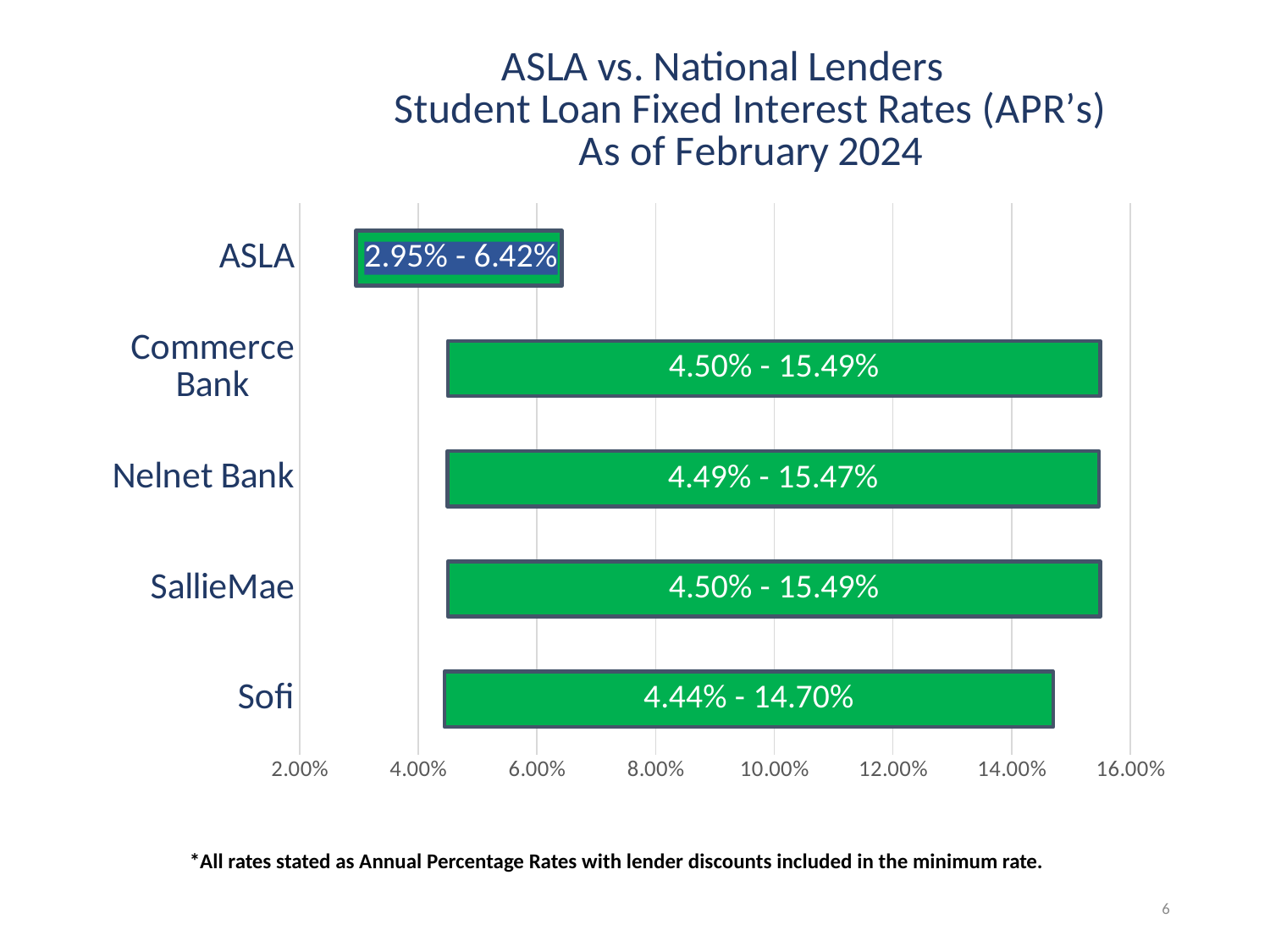
Is the upper end of the ASLA bar greater or less than 8.00%? less What interest rate range is shown for Sofi? 4.44% - 14.70% Which is larger, the maximum rate for Sofi or the maximum rate for ASLA? Sofi Which lender has the lowest maximum interest rate? ASLA What interest rate range is shown for Commerce Bank? 4.50% - 15.49% What is the maximum rate shown for SallieMae? 15.49% How many lenders are shown in the chart? 5 Which lender has the lowest minimum interest rate? ASLA What type of chart is shown on the slide? Bar chart What interest rate range is shown for ASLA? 2.95% - 6.42% What is the difference between the maximum rate for Sofi and the maximum rate for ASLA? 8.28% What interest rate range is shown for Nelnet Bank? 4.49% - 15.47%